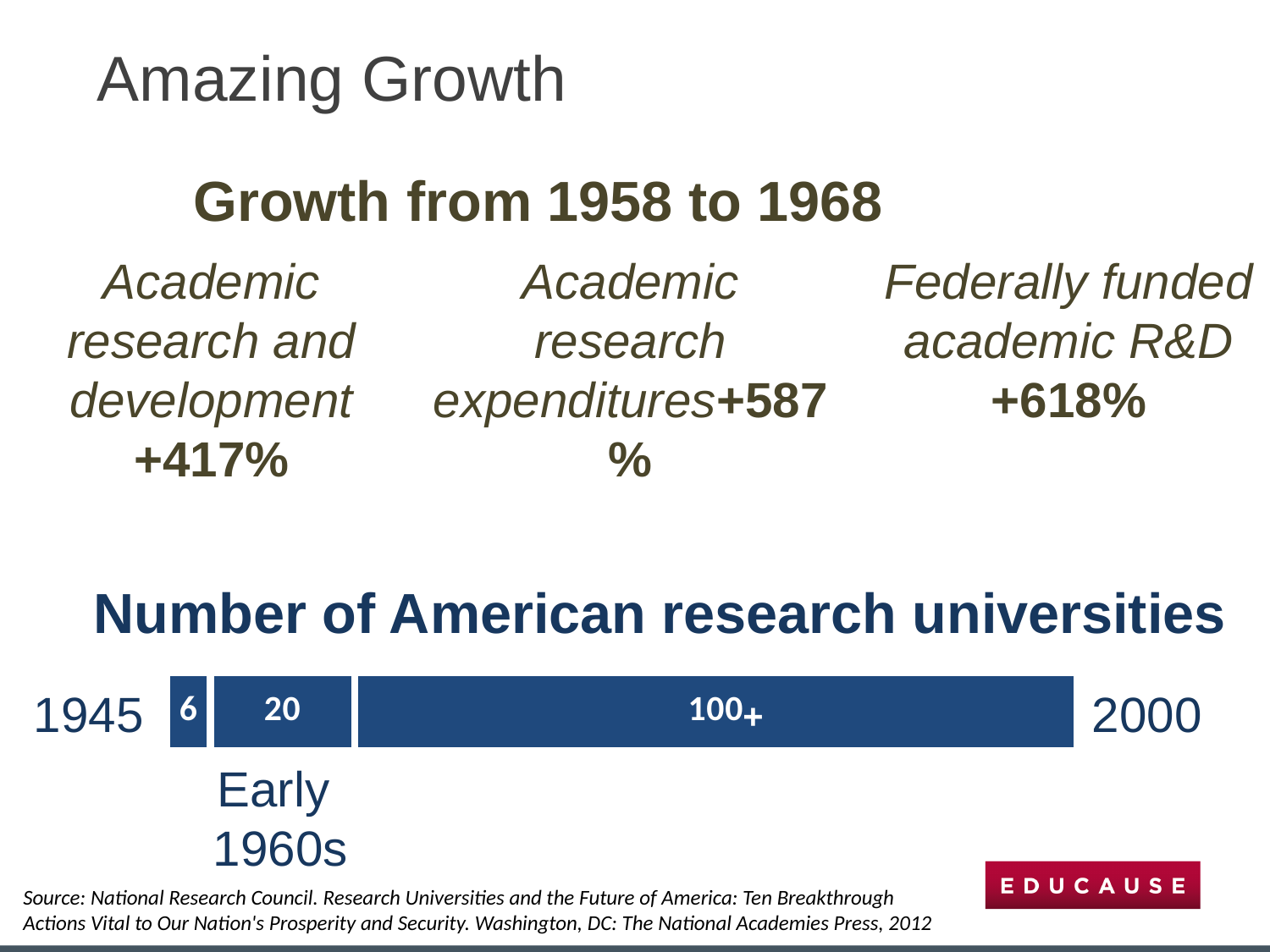
What kind of chart is used to show the number of American research universities? Bar chart How many time periods are shown in the 'Number of American research universities' chart? 3 In the 'Number of American research universities' chart, which is larger: the value for 1945 or the value for the early 1960s? Early 1960s In the 'Number of American research universities' chart, what value is shown for the early 1960s? 20 In the 'Number of American research universities' chart, which period has the lowest number of research universities? 1945 In the 'Number of American research universities' chart, what is the difference between the early 1960s value and the 1945 value? 14 In the 'Number of American research universities' chart, do the values rise or fall from 1945 to 2000? Rise What colour are the bars in the 'Number of American research universities' chart? Blue What is the title of the chart at the bottom of the slide? Number of American research universities In the 'Number of American research universities' chart, which period has the highest number of research universities? 2000 In the 'Number of American research universities' chart, what value is shown for 1945? 6 In the 'Number of American research universities' chart, what value is shown for 2000? 100+